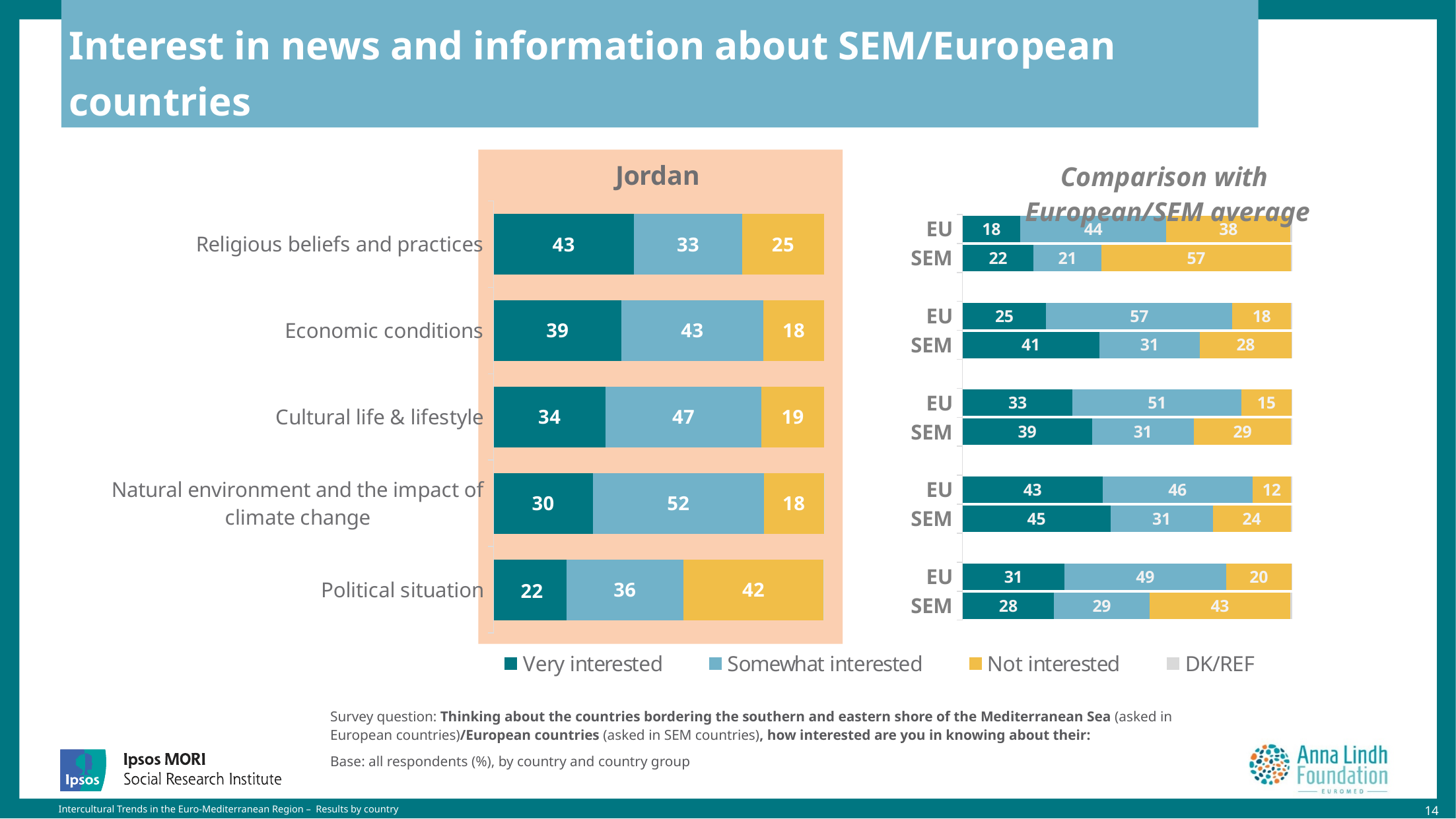
In the Comparison with European/SEM average chart, what is the total of the EU bar for Natural environment and the impact of climate change (43 + 46 + 12)? 101 In the Comparison with European/SEM average chart, what is the EU 'Somewhat interested' value for Economic conditions? 57 In the Jordan chart, which topic has the highest 'Somewhat interested' value? Natural environment and the impact of climate change What kind of chart is the Jordan chart? Stacked bar chart In the Jordan chart, how many topics are shown? 5 In the Comparison with European/SEM average chart, what is the SEM 'Not interested' value for Religious beliefs and practices? 57 In the Jordan chart, what percentage is 'Very interested' in Religious beliefs and practices? 43 How many series does the legend list? 4 In the Jordan chart, what percentage is 'Not interested' in the Political situation? 42 In the Jordan chart, which topic has the lowest 'Very interested' value? Political situation In the Comparison with European/SEM average chart, which is larger for the Political situation: the EU 'Very interested' value or the SEM 'Very interested' value? EU In the Jordan chart, what is the difference between the 'Very interested' values for Religious beliefs and practices and Economic conditions? 4